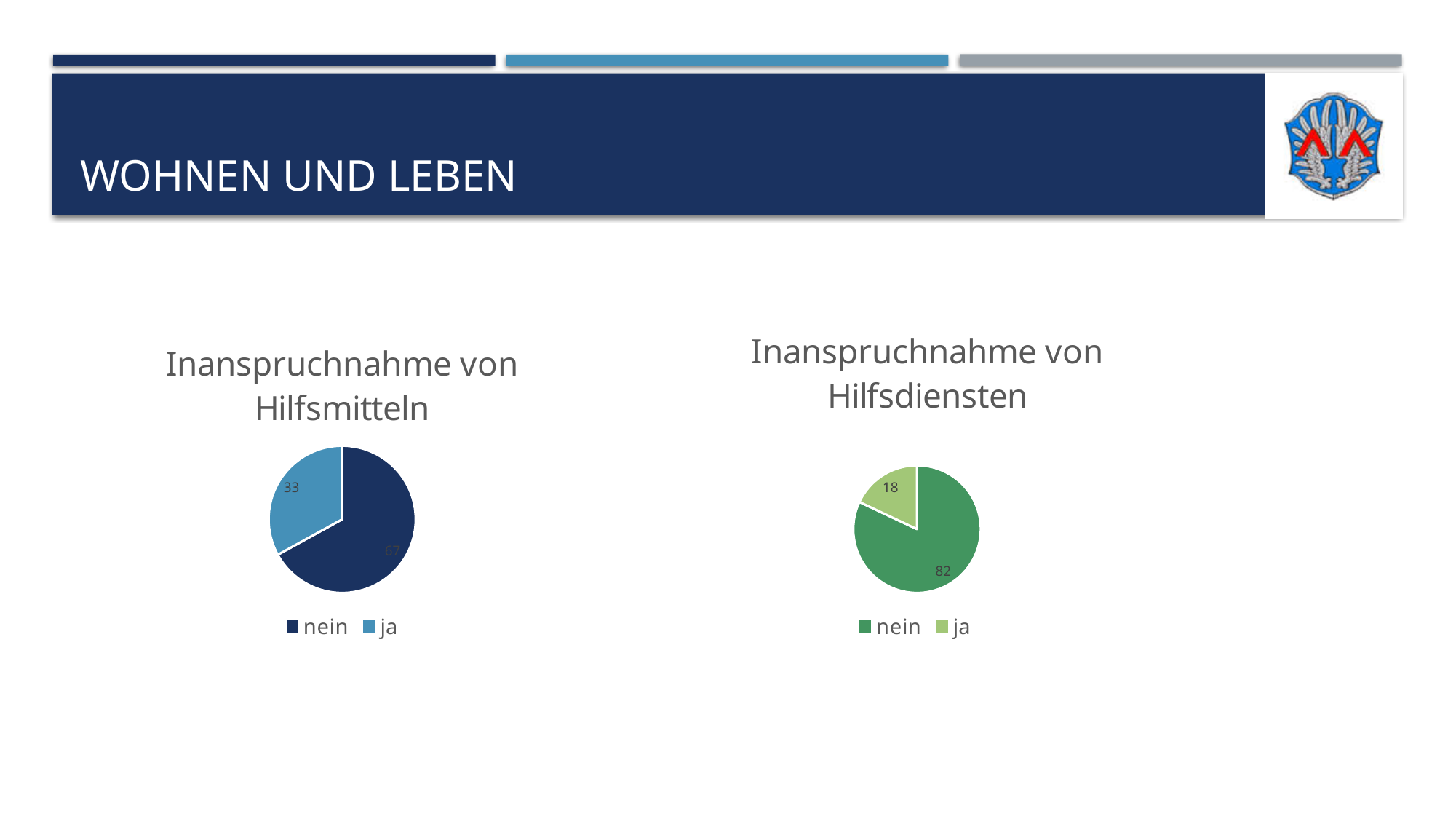
How many categories does the legend of the 'Inanspruchnahme von Hilfsmitteln' chart list? 2 In the 'Inanspruchnahme von Hilfsdiensten' chart, what is the difference between the 'nein' and 'ja' values? 64 In the 'Inanspruchnahme von Hilfsmitteln' chart, what is the difference between the 'nein' and 'ja' values? 34 In the 'Inanspruchnahme von Hilfsdiensten' chart, what is the value for 'nein'? 82 What colour is the 'ja' slice in the 'Inanspruchnahme von Hilfsdiensten' chart? light green Is the 'ja' value larger in the 'Inanspruchnahme von Hilfsmitteln' chart or in the 'Inanspruchnahme von Hilfsdiensten' chart? Inanspruchnahme von Hilfsmitteln In the 'Inanspruchnahme von Hilfsmitteln' chart, what is the value for 'ja'? 33 In the 'Inanspruchnahme von Hilfsdiensten' chart, which category has the smallest slice? ja In the 'Inanspruchnahme von Hilfsdiensten' chart, what is the value for 'ja'? 18 What type of chart is the 'Inanspruchnahme von Hilfsdiensten' chart? pie chart In the 'Inanspruchnahme von Hilfsmitteln' chart, which category has the largest slice? nein In the 'Inanspruchnahme von Hilfsmitteln' chart, what is the value for 'nein'? 67